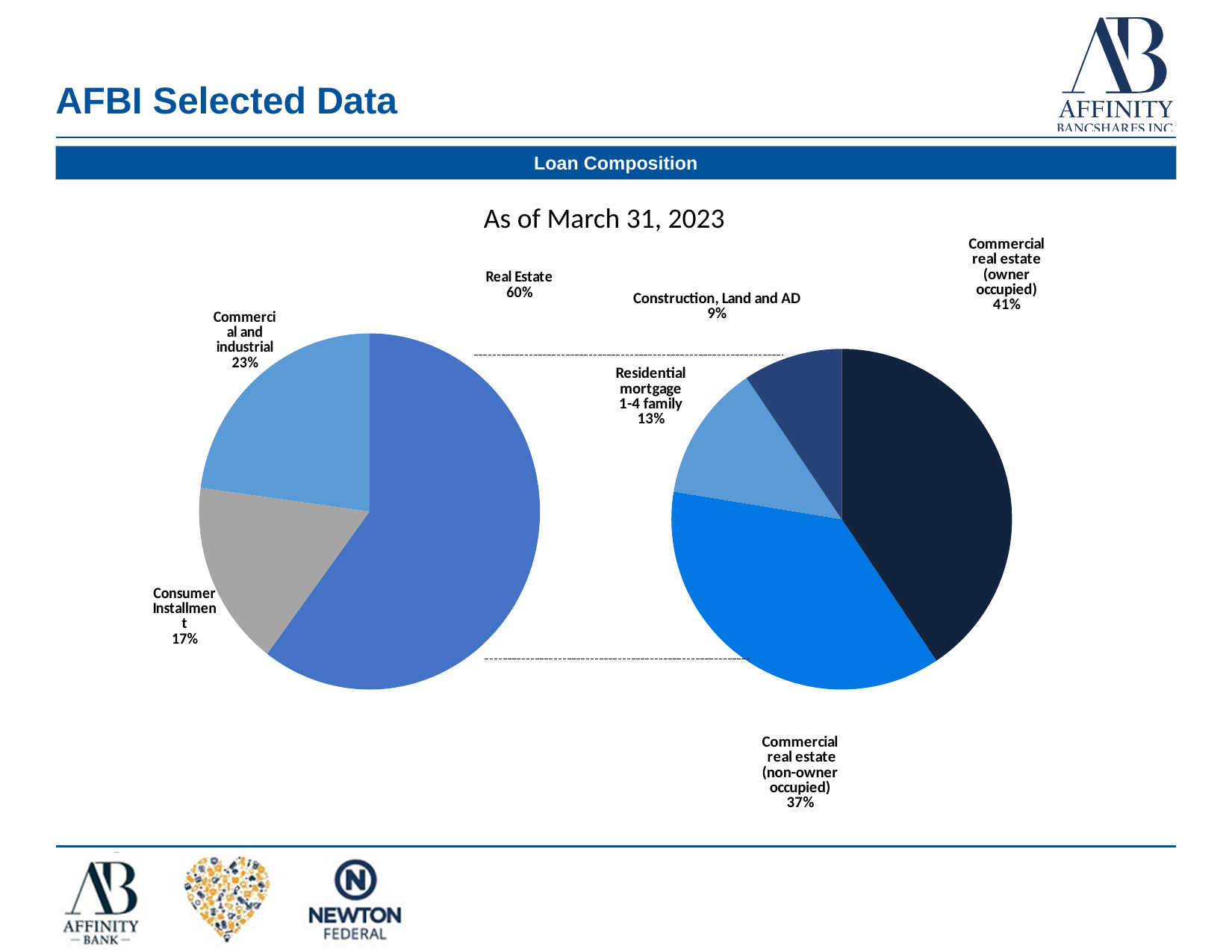
On the left pie chart, what share of loans is Real Estate? 60% What date is the loan composition data as of? March 31, 2023 On the right pie chart, which category has the smallest share? Construction, Land and AD What type of chart is used on this slide? Pie chart On the left pie chart, what share is Consumer Installment? 17% On the right pie chart, which is larger: Commercial real estate (owner occupied) or Commercial real estate (non-owner occupied)? Commercial real estate (owner occupied) On the right pie chart, what share is Construction, Land and AD? 9% On the left pie chart, which category has the largest share? Real Estate On the right pie chart, what share is Commercial real estate (owner occupied)? 41% How many slices does the right pie chart have? 4 On the right pie chart, what share is Residential mortgage 1-4 family? 13% On the left pie chart, what is the difference in percentage points between Commercial and industrial and Consumer Installment? 6